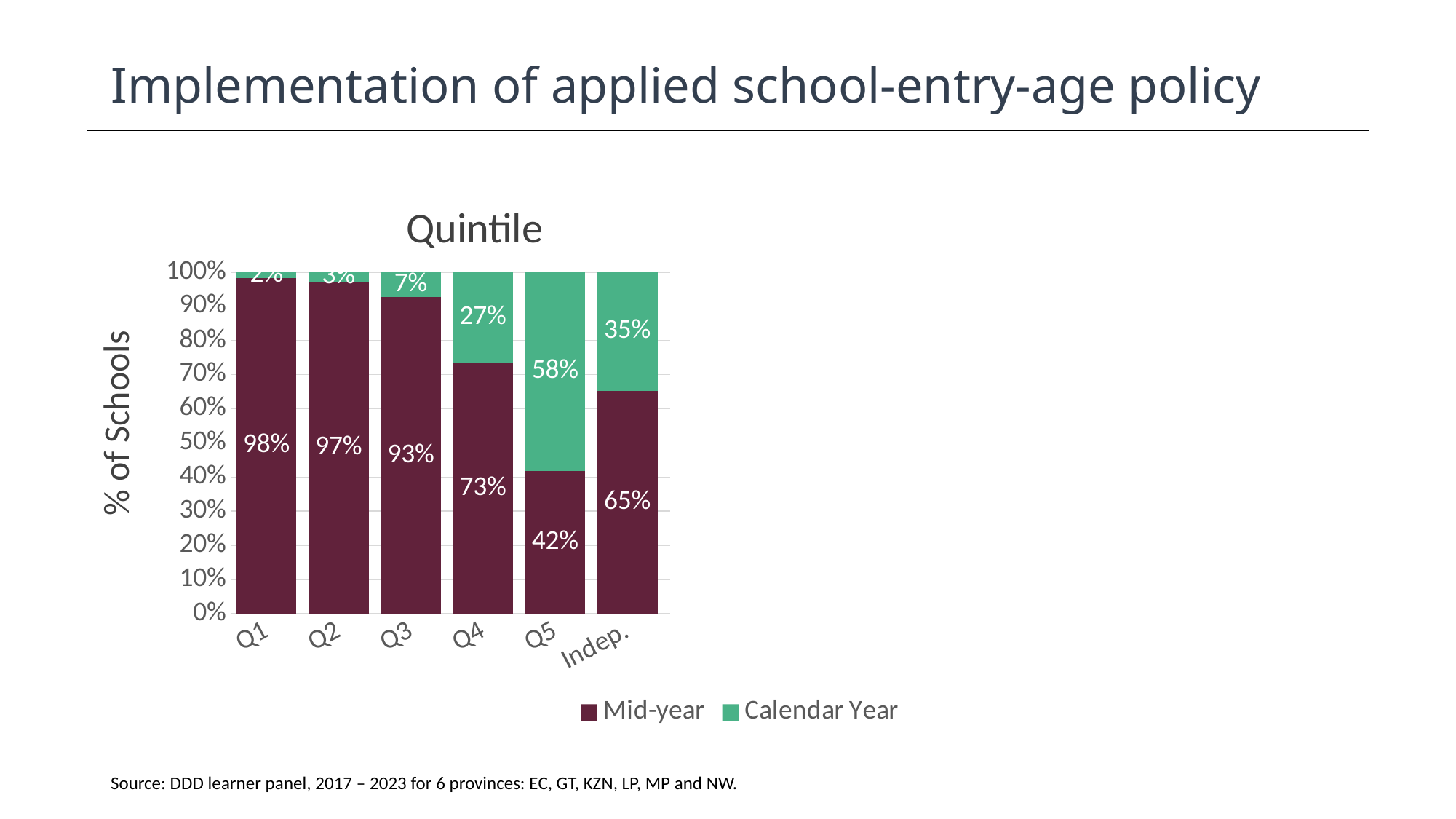
How many series does the legend list? 2 Which category has the lowest Mid-year value? Q5 What is the Calendar Year value for Q4? 27% Which has the larger Mid-year value, Q5 or Indep.? Indep. Which category has the highest Calendar Year value? Q5 What kind of chart is shown on the slide? Stacked bar chart What is the Mid-year value for Indep.? 65% Do the Mid-year values rise or fall from Q1 to Q5? Fall How many categories are shown on the x axis? 6 What is the difference between the Mid-year values for Q3 and Q4? 20% What is the Mid-year value for Q5? 42% Which category has the highest Mid-year value? Q1